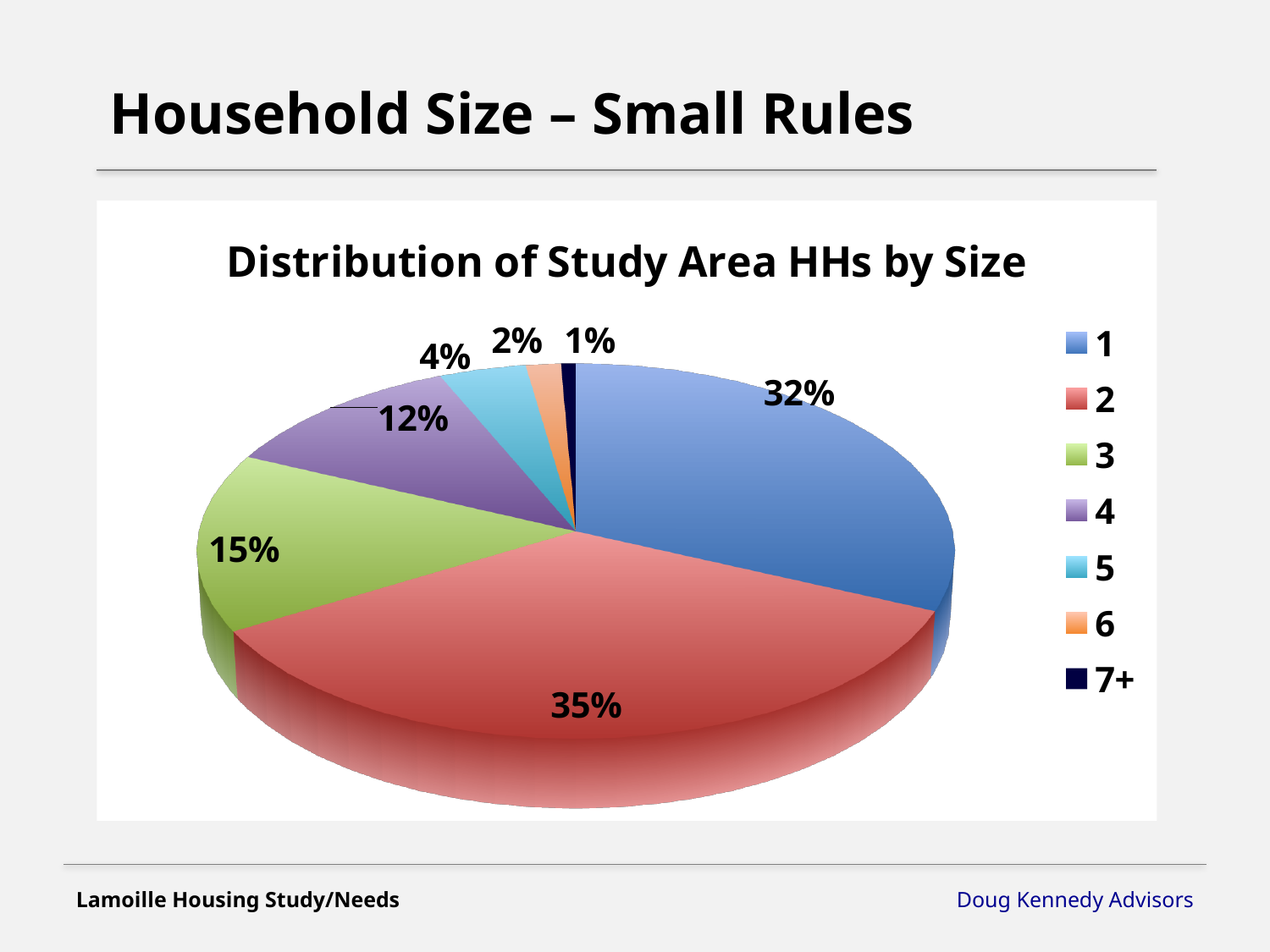
What is the title of the chart? Distribution of Study Area HHs by Size What share of households have a size of 2? 35% Which household size has the smallest share of the pie? 7+ What kind of chart is shown on the slide? pie chart What share of households have a size of 7+? 1% What share of households have a size of 1? 32% What share of households have a size of 4? 12% What is the difference in percentage points between the shares for household size 2 and household size 1? 3% Which household size has the largest share of the pie? 2 Which has a larger share, household size 3 or household size 4? 3 What share of households have a size of 3? 15% How many household size categories does the legend list? 7